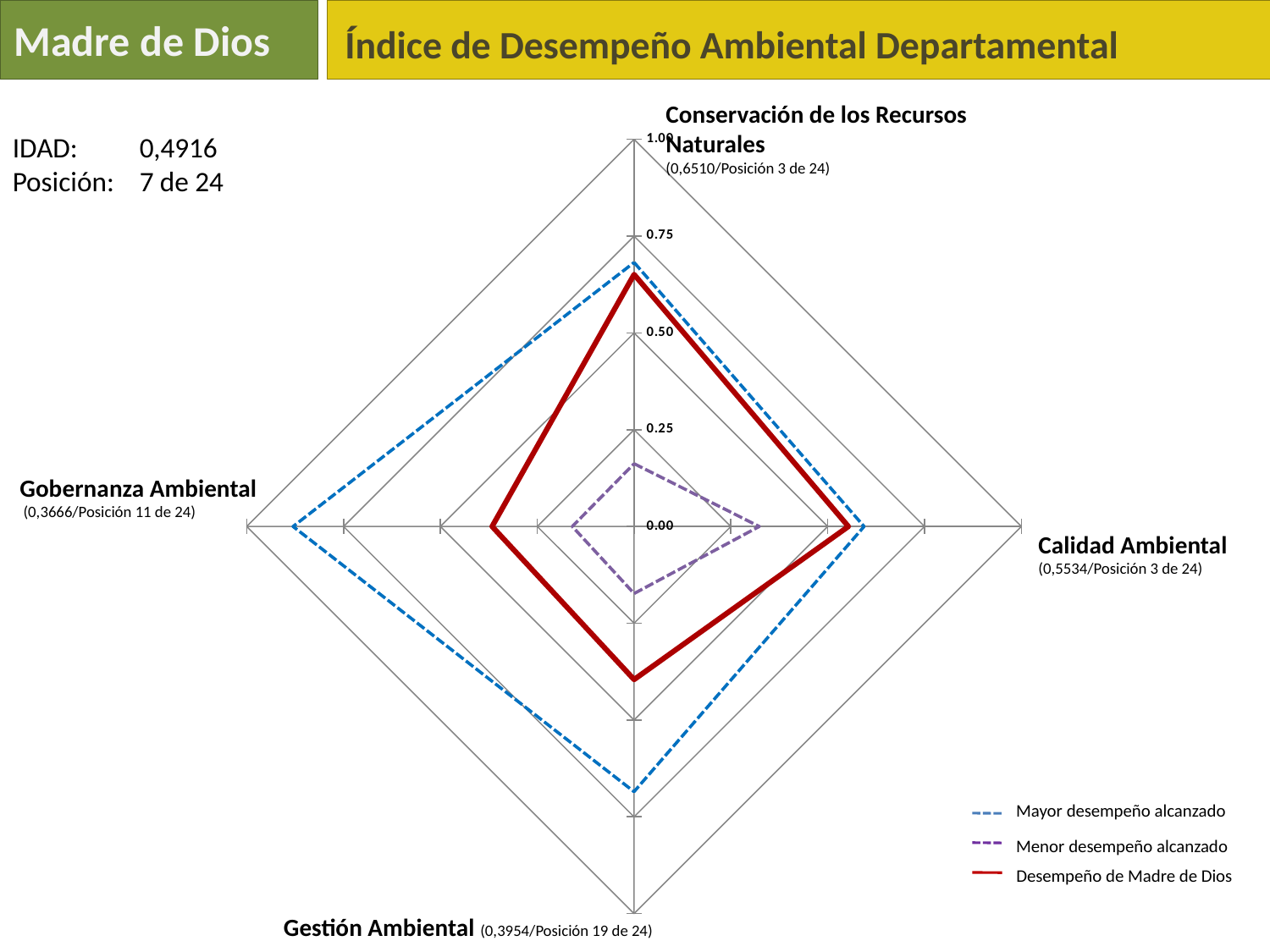
Which of the four dimensions has the highest value for Madre de Dios? Conservación de los Recursos Naturales How many dimensions (axes) does the radar chart have? 4 What is the difference between the Madre de Dios values for Conservación de los Recursos Naturales and Gobernanza Ambiental? 0,2844 What is the value for Conservación de los Recursos Naturales for Madre de Dios? 0,6510 How many series does the legend list? 3 Which is larger for Madre de Dios: Calidad Ambiental or Gestión Ambiental? Calidad Ambiental Is the value of Mayor desempeño alcanzado for Gobernanza Ambiental greater or less than 0.75? greater What is the value for Gestión Ambiental for Madre de Dios? 0,3954 Is the value of Menor desempeño alcanzado for Gestión Ambiental greater or less than 0.25? less Which of the four dimensions has the lowest value for Madre de Dios? Gobernanza Ambiental What position does Madre de Dios hold in Gobernanza Ambiental? 11 de 24 What kind of chart is shown on the slide? Radar chart